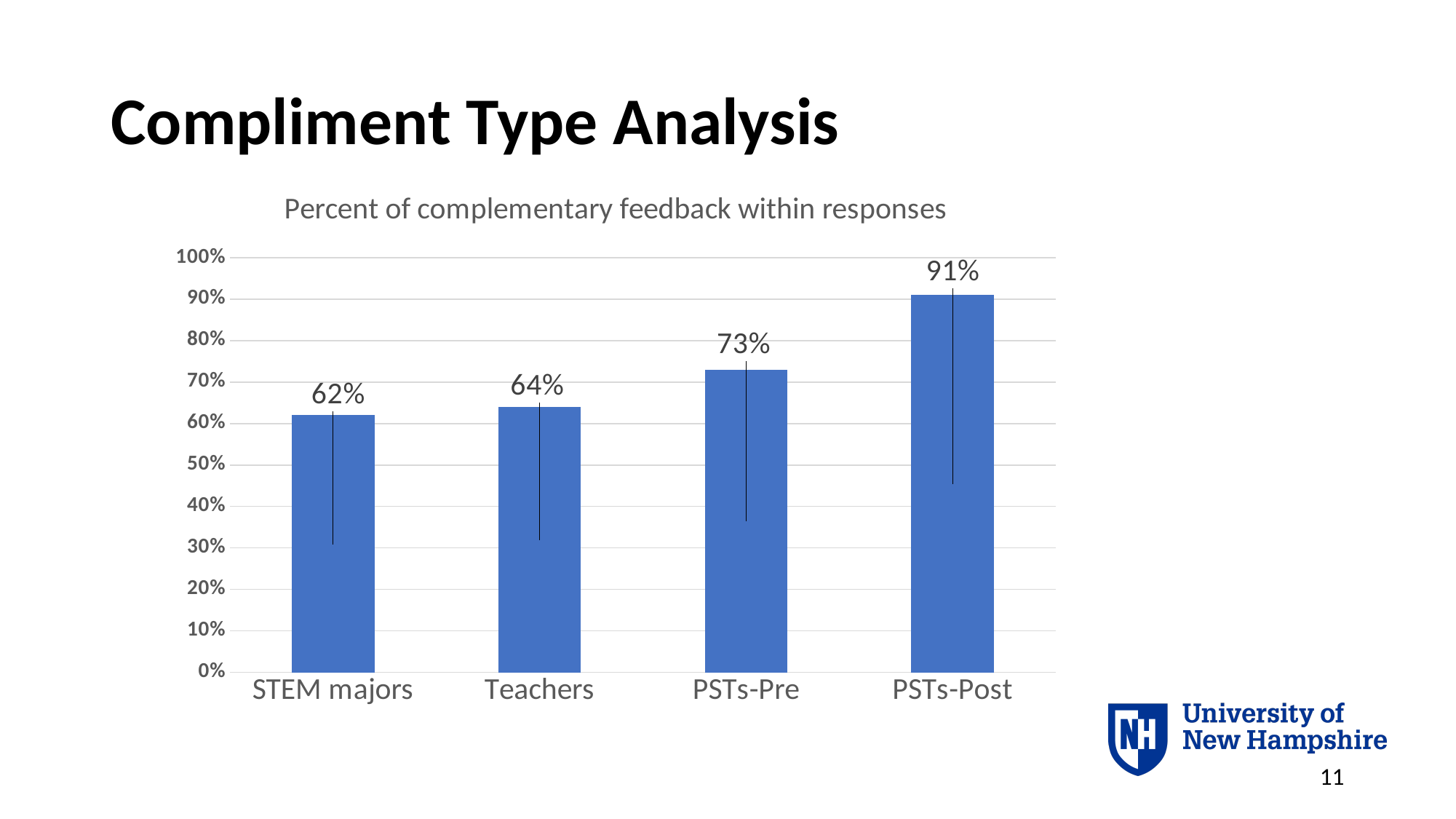
What is the title of the chart? Percent of complementary feedback within responses What is the value for PSTs-Pre? 73% How many categories are shown on the x axis? 4 Which category has the highest value? PSTs-Post What is the value for PSTs-Post? 91% Which is larger, the value for Teachers or the value for PSTs-Pre? PSTs-Pre What is the value for Teachers? 64% Which category has the lowest value? STEM majors What is the difference between the values for PSTs-Post and PSTs-Pre? 18% What kind of chart is shown on the slide? bar chart Is the value for PSTs-Post greater or less than 80%? greater What is the value for STEM majors? 62%